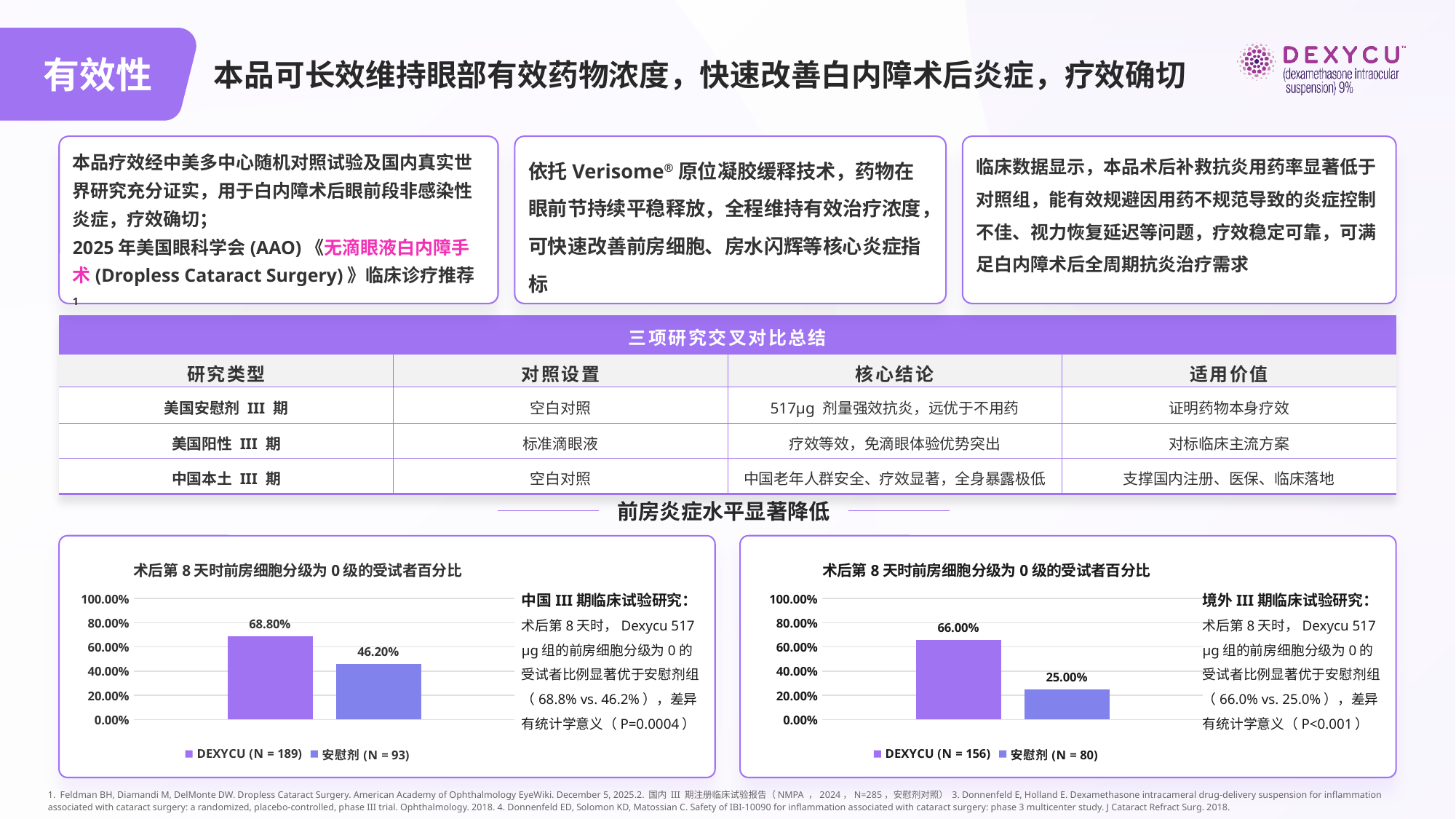
In the right chart, what is the value for DEXYCU (N = 156)? 66.00% In the right chart, what is the value for 安慰剂 (N = 80)? 25.00% In the right chart, what is the difference between the DEXYCU (N = 156) value and the 安慰剂 (N = 80) value? 41.00% How many series does the legend of the left chart list? 2 What is the title of the left chart? 术后第 8 天时前房细胞分级为 0 级的受试者百分比 What kind of chart is the right chart? bar chart In the right chart, is the value for 安慰剂 (N = 80) greater or less than 40.00%? less In the left chart, what is the value for 安慰剂 (N = 93)? 46.20% In the left chart, what is the value for DEXYCU (N = 189)? 68.80% In the left chart, what is the difference between the DEXYCU (N = 189) value and the 安慰剂 (N = 93) value? 22.60% In the right chart, which group has the lower value? 安慰剂 (N = 80) In the left chart, which group has the higher value? DEXYCU (N = 189)